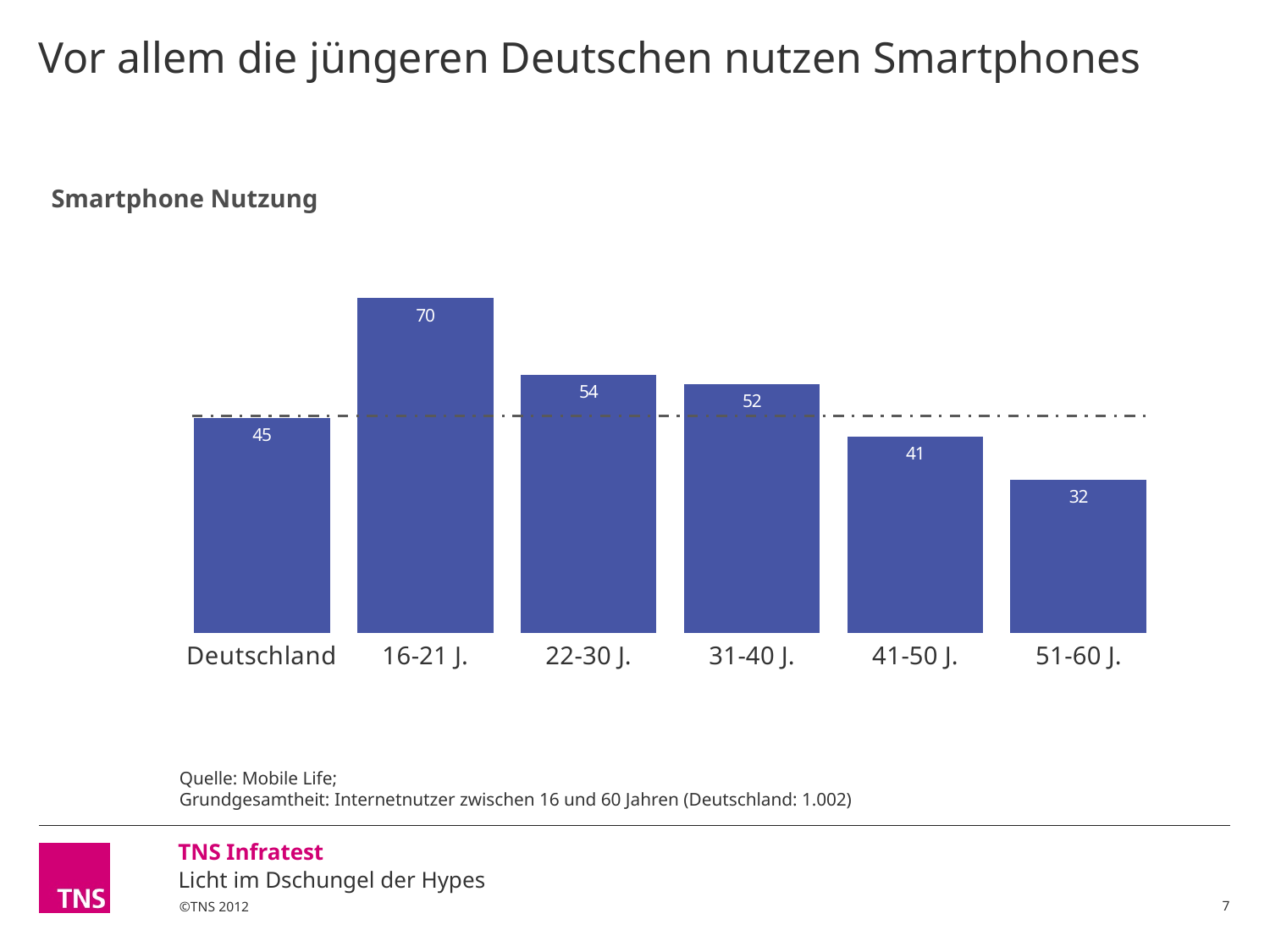
How many categories are shown on the x axis? 6 What kind of chart is shown on the slide? Bar chart Which category has the highest value? 16-21 J. What is the value for the 31-40 J. age group? 52 What is the value for the 51-60 J. age group? 32 What is the value for Deutschland? 45 What is the value for the 16-21 J. age group? 70 Do the values rise or fall across the age groups from 16-21 J. to 51-60 J.? Fall What is the difference between the values for 22-30 J. and 41-50 J.? 13 Which category has the lowest value? 51-60 J. Which is larger, the value for 22-30 J. or the value for 41-50 J.? 22-30 J. What is the difference between the values for 16-21 J. and 51-60 J.? 38